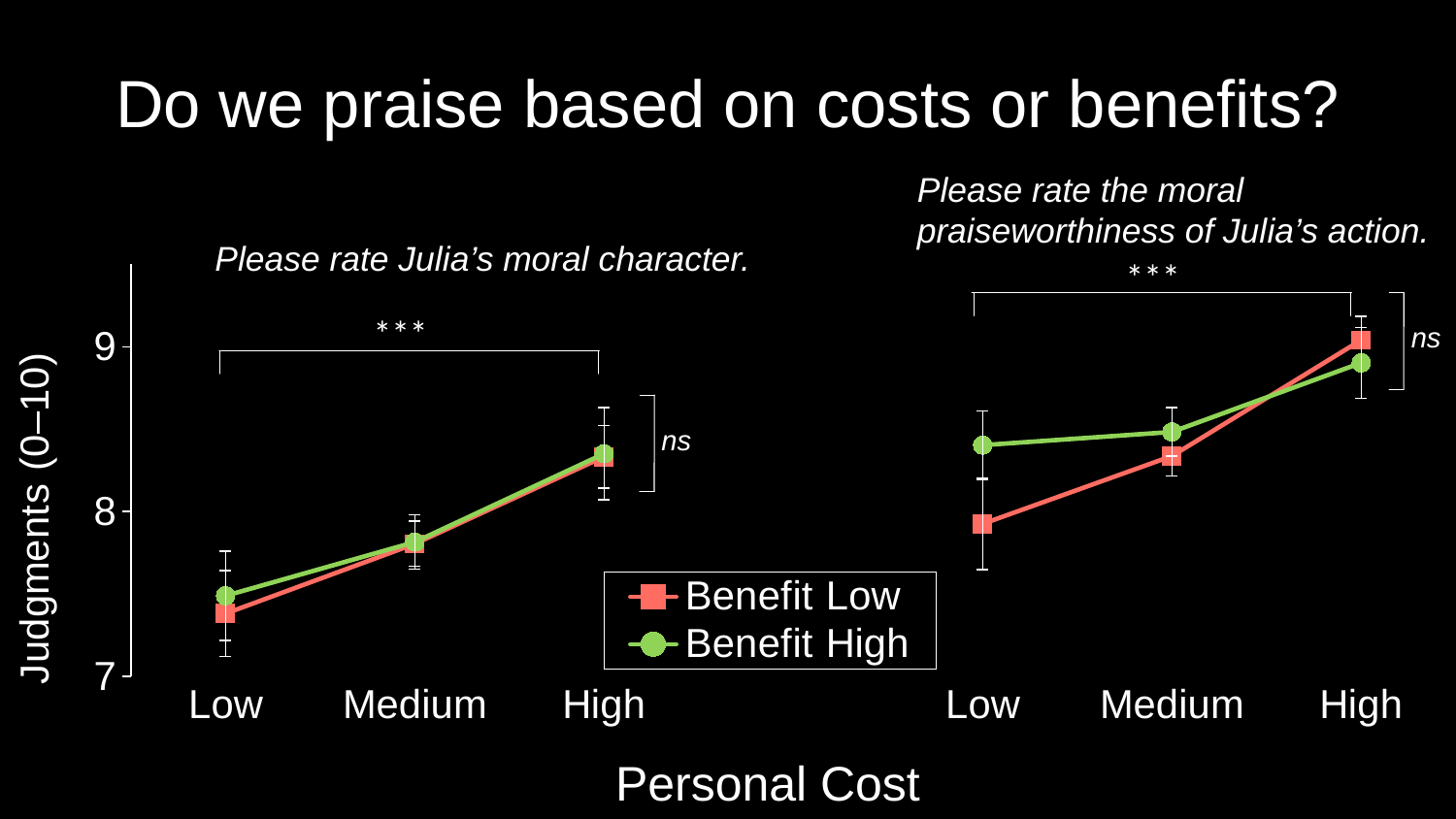
In the left chart ("Please rate Julia's moral character."), at which Personal Cost level is the Benefit Low value lowest? Low In the left chart ("Please rate Julia's moral character."), is the Benefit High value at High personal cost greater or less than 8? greater In the left chart ("Please rate Julia's moral character."), do the Benefit High values rise or fall as Personal Cost goes from Low to High? rise What kind of chart is used on this slide? line chart How many series does the legend list? 2 In the right chart ("Please rate the moral praiseworthiness of Julia's action."), at which Personal Cost level is the Benefit Low value highest? High What is the label of the y axis? Judgments (0–10) In the right chart ("Please rate the moral praiseworthiness of Julia's action."), is the Benefit High value at Low personal cost greater or less than 8? greater In the left chart ("Please rate Julia's moral character."), is the Benefit Low value at Low personal cost greater or less than 8? less In the right chart ("Please rate the moral praiseworthiness of Julia's action."), do the Benefit Low values rise or fall as Personal Cost goes from Low to High? rise In the right chart ("Please rate the moral praiseworthiness of Julia's action."), at Low personal cost, which series has the larger value: Benefit Low or Benefit High? Benefit High In the left chart ("Please rate Julia's moral character."), how many Personal Cost categories are shown on the x axis? 3